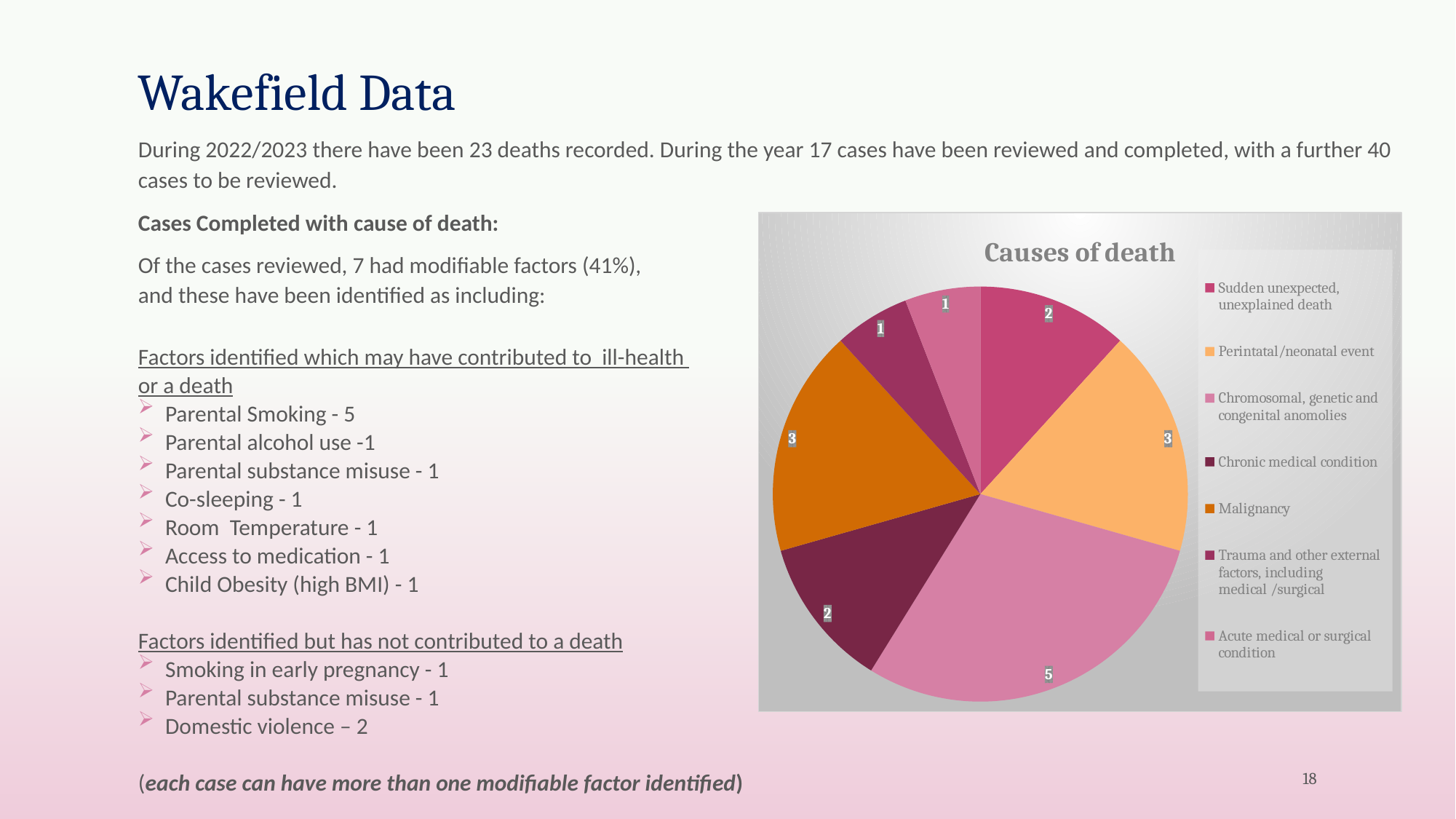
What colour is the Malignancy slice in the Causes of death chart? Orange What is the value for Malignancy in the Causes of death chart? 3 What is the value for Chromosomal, genetic and congenital anomolies in the Causes of death chart? 5 What is the value for Sudden unexpected, unexplained death in the Causes of death chart? 2 What is the total of all the slice values in the Causes of death chart? 17 What is the title of the chart? Causes of death What kind of chart is shown on the slide? Pie chart How many categories does the legend of the Causes of death chart list? 7 Which cause of death has the largest slice in the chart? Chromosomal, genetic and congenital anomolies Which is larger in the Causes of death chart: Malignancy or Chronic medical condition? Malignancy What is the difference between the values for Chromosomal, genetic and congenital anomolies and Perintatal/neonatal event? 2 What is the value for Acute medical or surgical condition in the Causes of death chart? 1